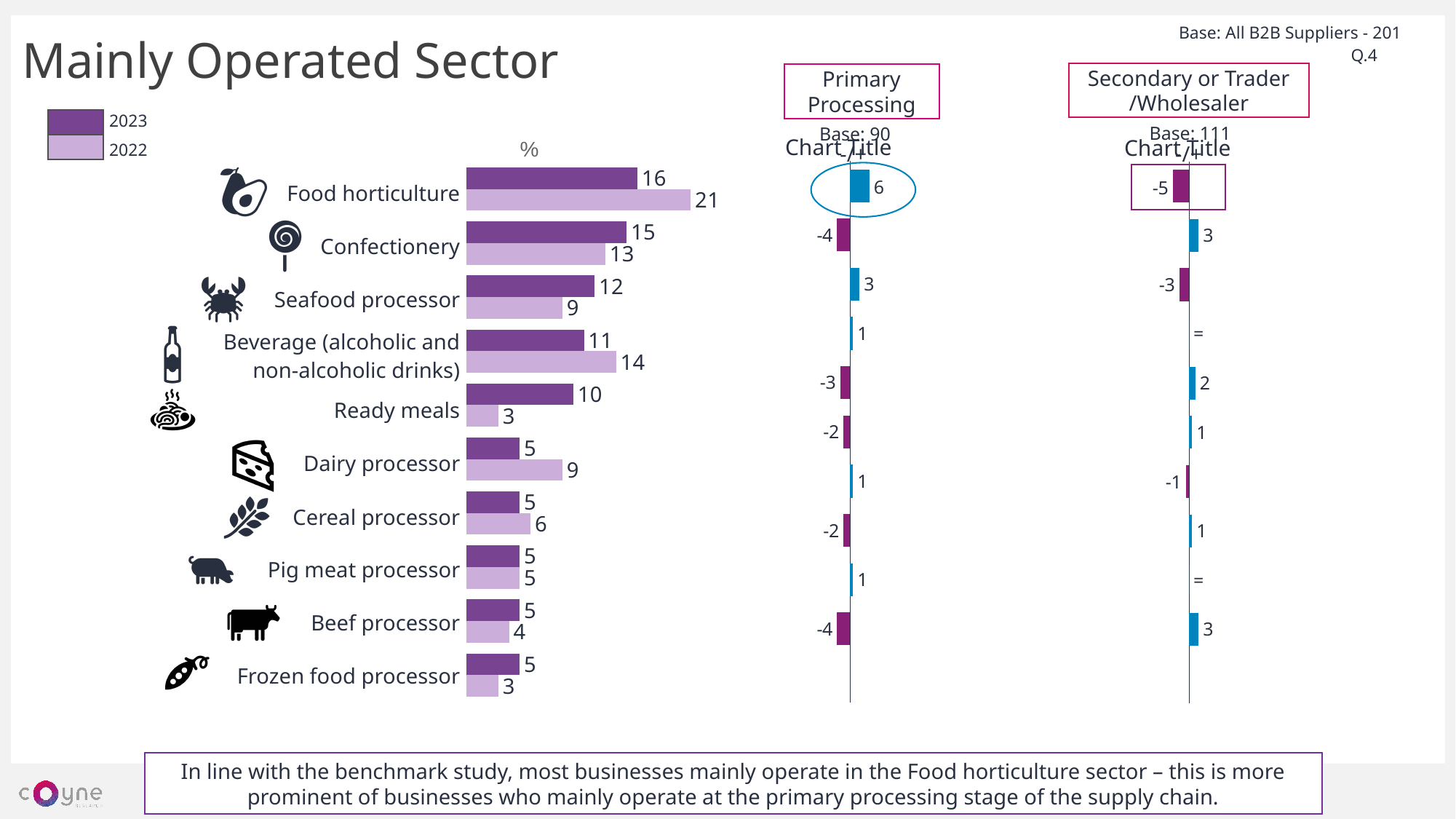
What kind of chart is the main chart showing sectors? Bar chart What is the base shown for the Secondary or Trader/Wholesaler chart? Base: 111 How many series does the legend of the main bar chart list? 2 In the main bar chart, which sector has the lowest 2023 value among those above 5? Ready meals In the Secondary or Trader/Wholesaler chart, what is the value for Food horticulture? -5 In the main bar chart, which sector has the highest 2022 value? Food horticulture In the main bar chart, what is the difference between the 2022 and 2023 values for Food horticulture? 5 In the main bar chart, what is the 2023 value for Food horticulture? 16 In the main bar chart, which is larger for Dairy processor: the 2023 value or the 2022 value? 2022 In the Primary Processing chart, what is the value for Food horticulture? 6 In the main bar chart, what is the 2022 value for Ready meals? 3 How many sectors are listed in the main bar chart? 10